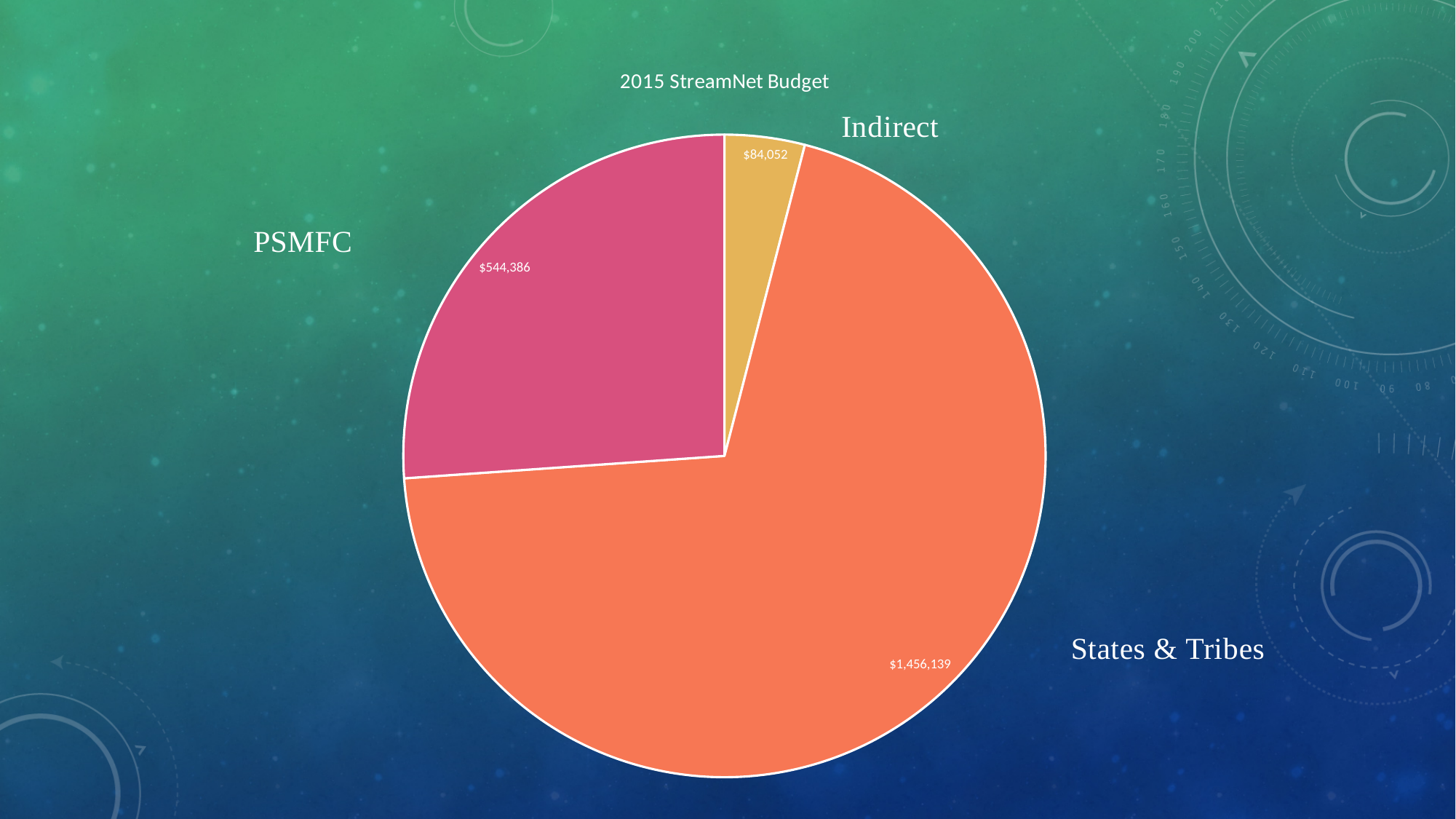
What kind of chart is shown on the slide? Pie chart What colour is the States & Tribes slice? Orange What is the value of the States & Tribes slice? $1,456,139 What is the value of the Indirect slice? $84,052 What is the difference between the States & Tribes value and the PSMFC value? $911,753 What is the difference between the PSMFC value and the Indirect value? $460,334 How many slices does the pie chart have? 3 What is the title of the chart? 2015 StreamNet Budget Which category has the smallest slice of the pie? Indirect Which category has the largest slice of the pie? States & Tribes What is the value of the PSMFC slice? $544,386 Which is larger, the PSMFC slice or the Indirect slice? PSMFC